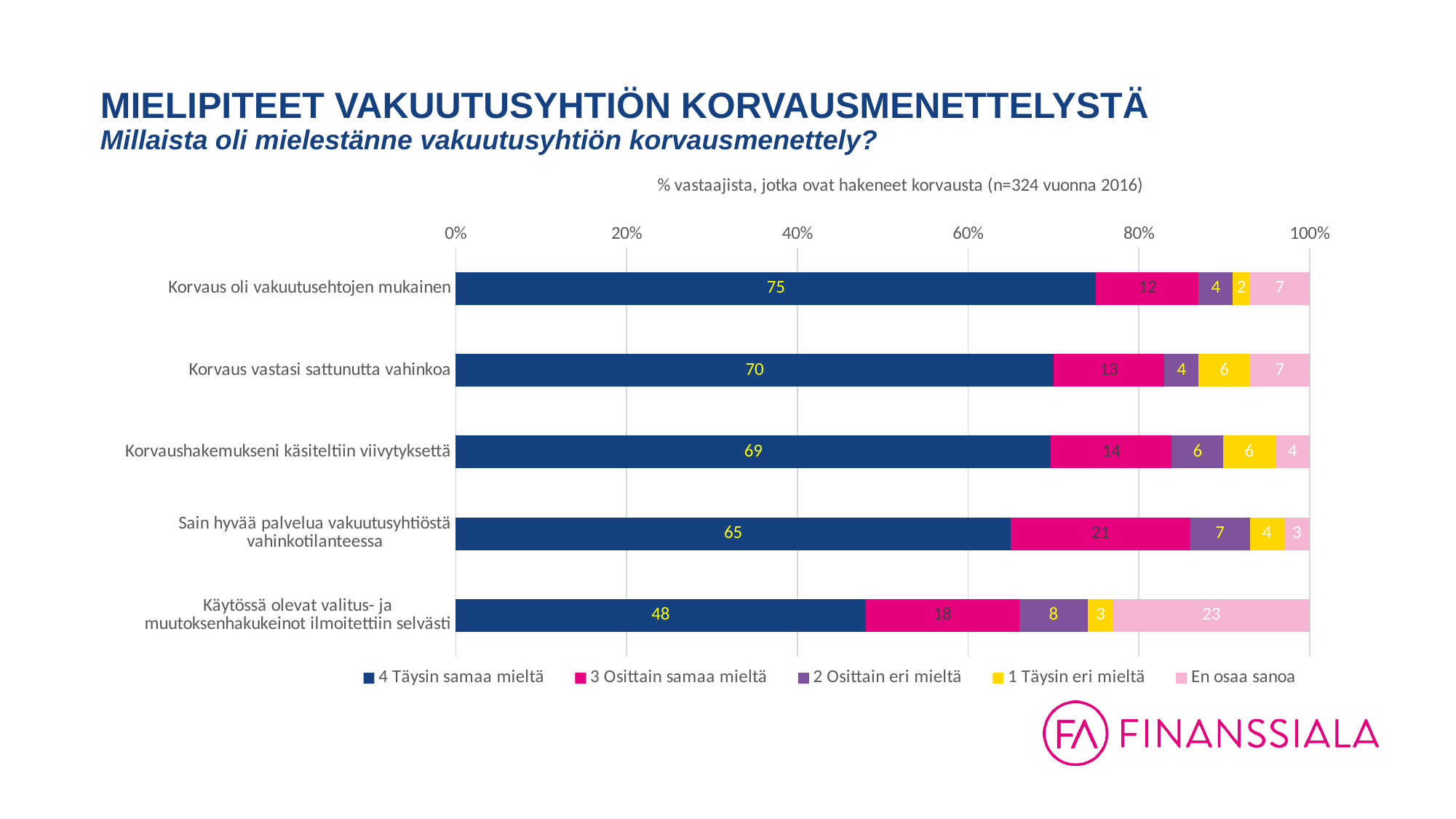
Which has a larger "1 Täysin eri mieltä" value: "Korvaus vastasi sattunutta vahinkoa" or "Korvaus oli vakuutusehtojen mukainen"? Korvaus vastasi sattunutta vahinkoa What is the total of the stacked bar for "Korvaushakemukseni käsiteltiin viivytyksettä"? 99 Which statement has the highest "4 Täysin samaa mieltä" value? Korvaus oli vakuutusehtojen mukainen What is the "En osaa sanoa" value for "Käytössä olevat valitus- ja muutoksenhakukeinot ilmoitettiin selvästi"? 23 What is the "3 Osittain samaa mieltä" value for "Sain hyvää palvelua vakuutusyhtiöstä vahinkotilanteessa"? 21 What is the sample size stated in the chart subtitle? n=324 What is the difference between the "4 Täysin samaa mieltä" values for "Korvaus oli vakuutusehtojen mukainen" and "Korvaus vastasi sattunutta vahinkoa"? 5 Which statement has the lowest "4 Täysin samaa mieltä" value? Käytössä olevat valitus- ja muutoksenhakukeinot ilmoitettiin selvästi How many series does the legend list? 5 What kind of chart is shown on the slide? Stacked bar chart What percentage of respondents answered "4 Täysin samaa mieltä" for "Korvaus oli vakuutusehtojen mukainen"? 75 How many statements (categories) are shown in the chart? 5